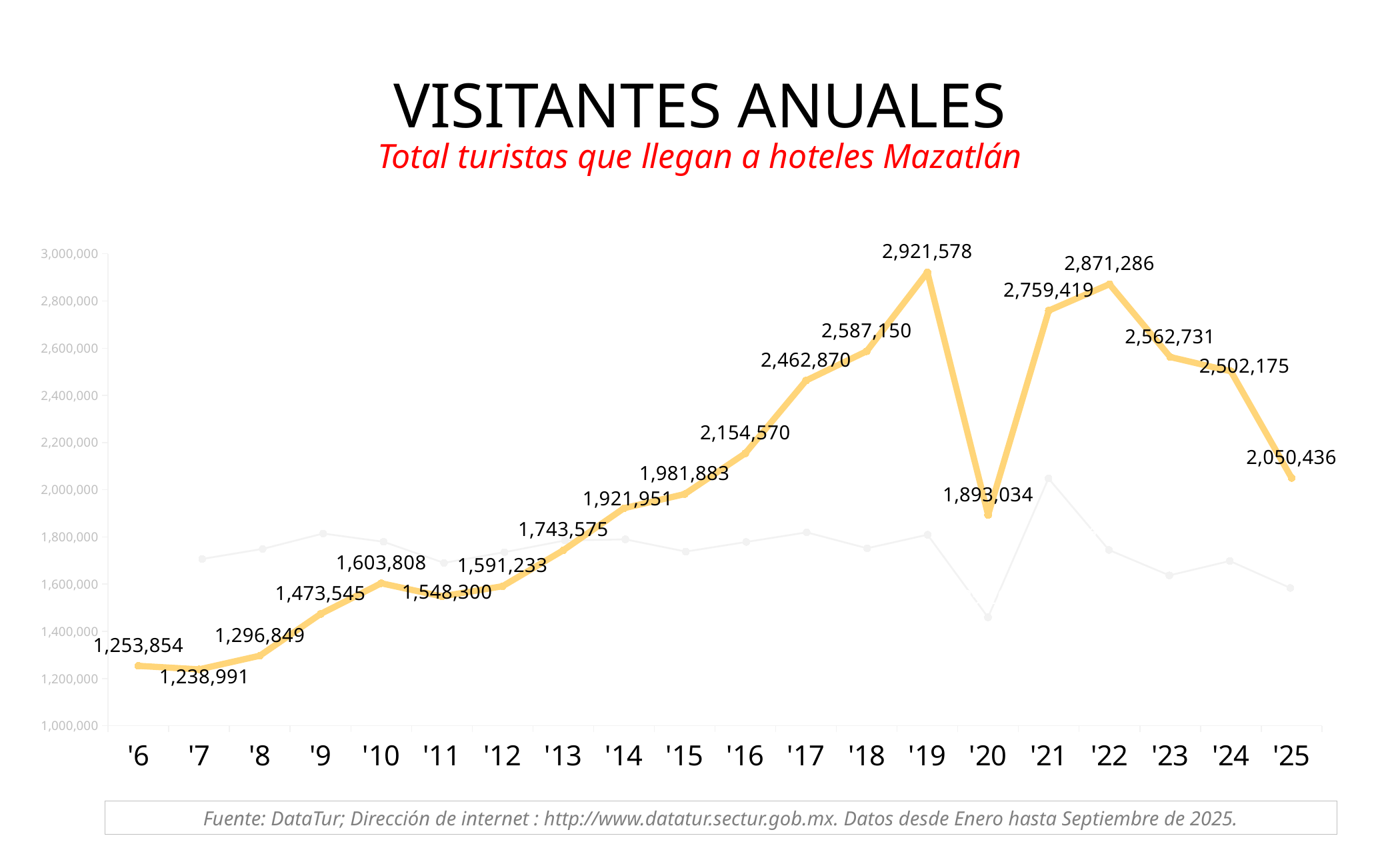
What is the value for '25? 2,050,436 What is the difference between the values for '19 and '20? 1,028,544 Which is larger, the value for '21 or the value for '22? '22 Which year has the lowest value? '7 What is the value for '20? 1,893,034 What kind of chart is shown? line chart Is the value for '20 greater or less than 2,000,000? less How many years are plotted on the x axis? 20 Do the values rise or fall from '6 to '19? rise Which year has the highest value? '19 What is the value for '19? 2,921,578 What is the difference between the values for '24 and '25? 451,739